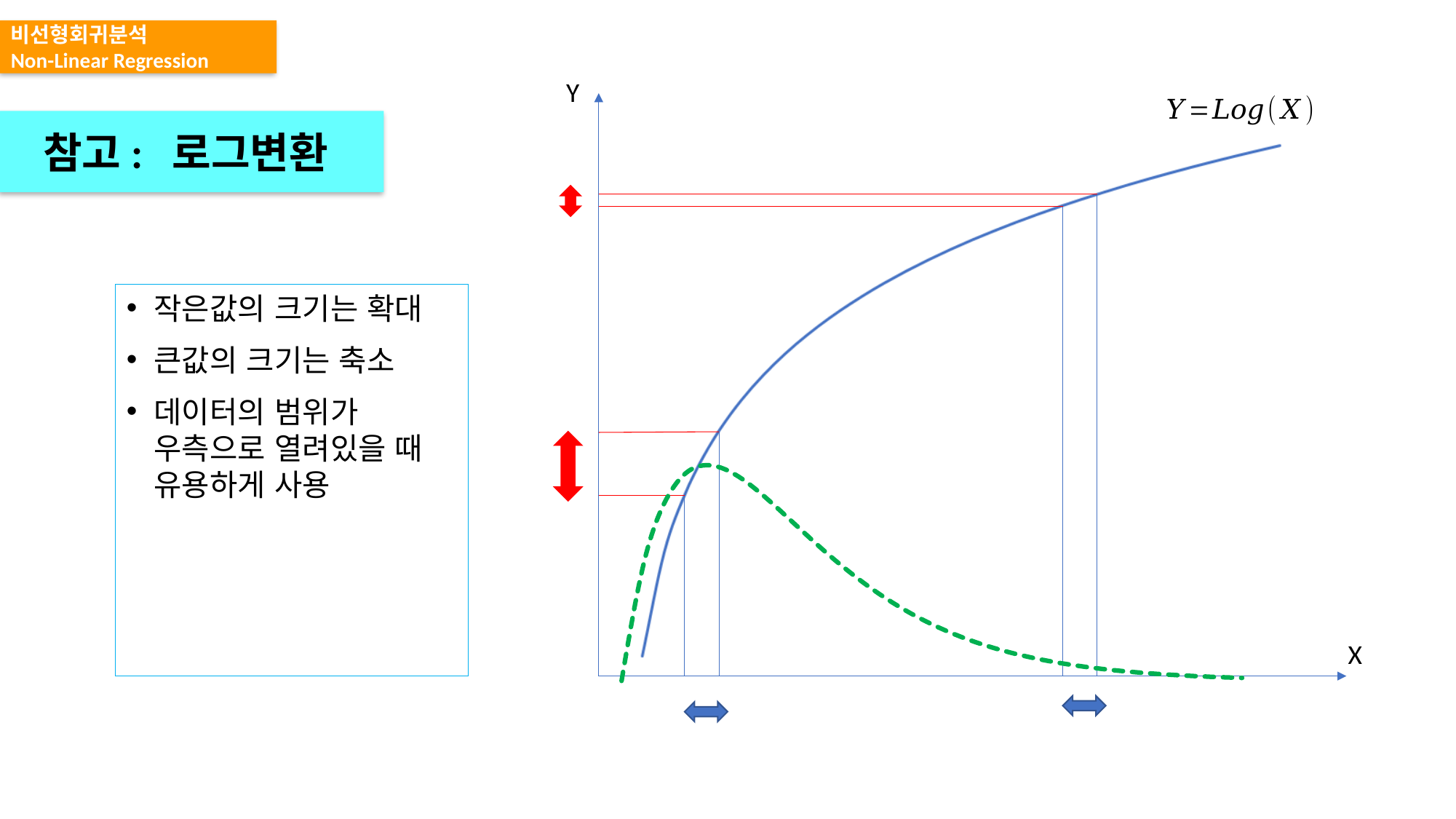
How many curves are plotted on the chart? 2 What kind of chart is shown on the slide? line chart Which curve is drawn as a dashed line, the blue one or the green one? the green one Does the green dashed curve rise or fall on the right-hand side of the chart, after its peak? falls Does the blue solid curve rise or fall as X increases? rises What equation is written at the top right of the chart? Y = Log(X)